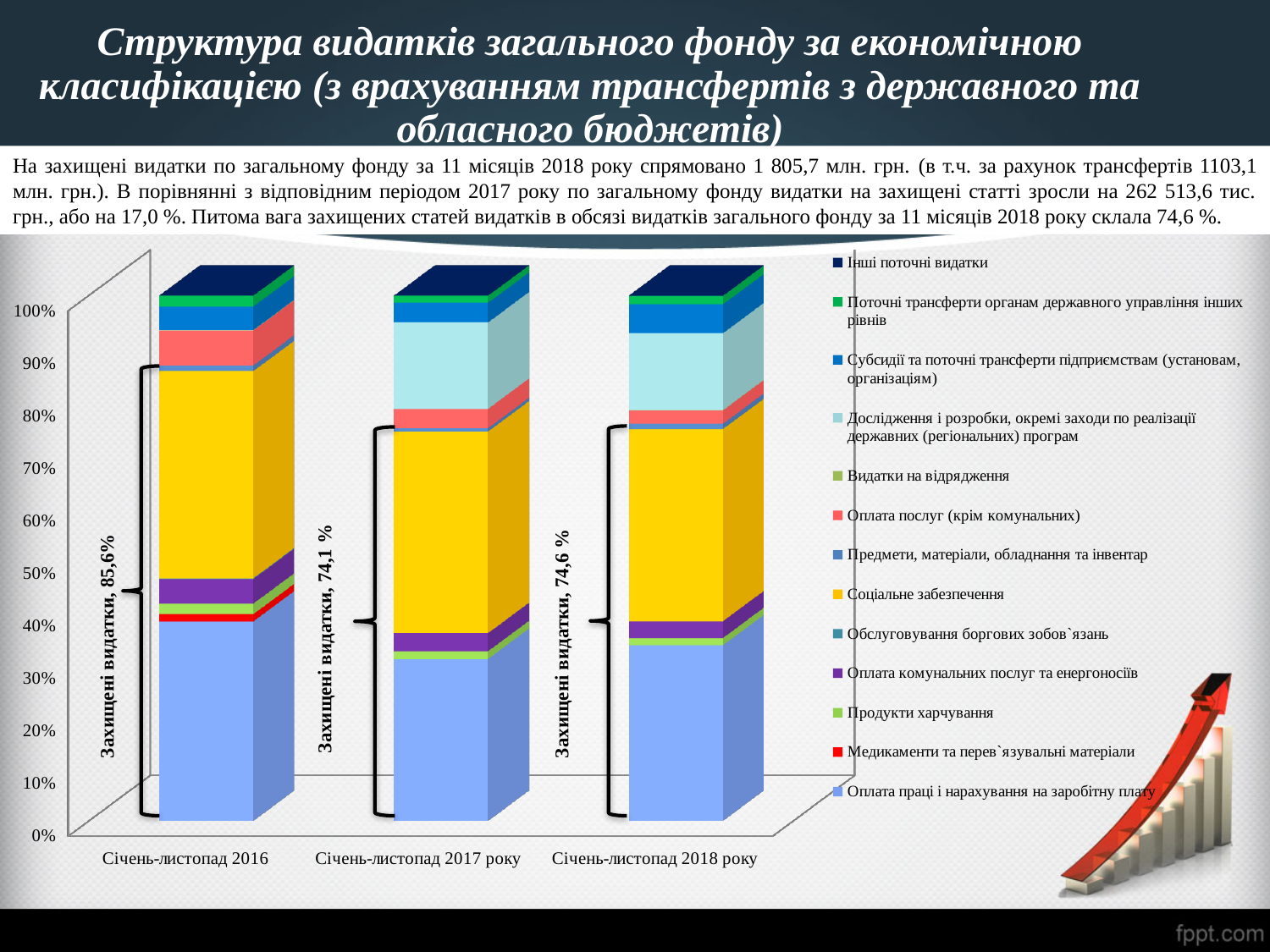
What share of protected expenditures (Захищені видатки) is labelled for Січень-листопад 2016? 85,6% Which period has the lowest labelled share of protected expenditures? Січень-листопад 2017 року By how many percentage points does the protected expenditure share for Січень-листопад 2016 exceed that for Січень-листопад 2018 року? 11,0 What share of protected expenditures (Захищені видатки) is labelled for Січень-листопад 2018 року? 74,6 % Which is larger: the protected expenditure share for Січень-листопад 2017 року or for Січень-листопад 2018 року? Січень-листопад 2018 року What kind of chart is shown on the slide? Stacked bar chart How many bars (periods) are plotted on the chart? 3 Which series is shown in yellow in the legend? Соціальне забезпечення Is the Оплата праці і нарахування на заробітну плату segment for Січень-листопад 2016 greater or less than 30%? greater How many series does the chart legend list? 13 Which period has the highest labelled share of protected expenditures? Січень-листопад 2016 What share of protected expenditures (Захищені видатки) is labelled for Січень-листопад 2017 року? 74,1 %